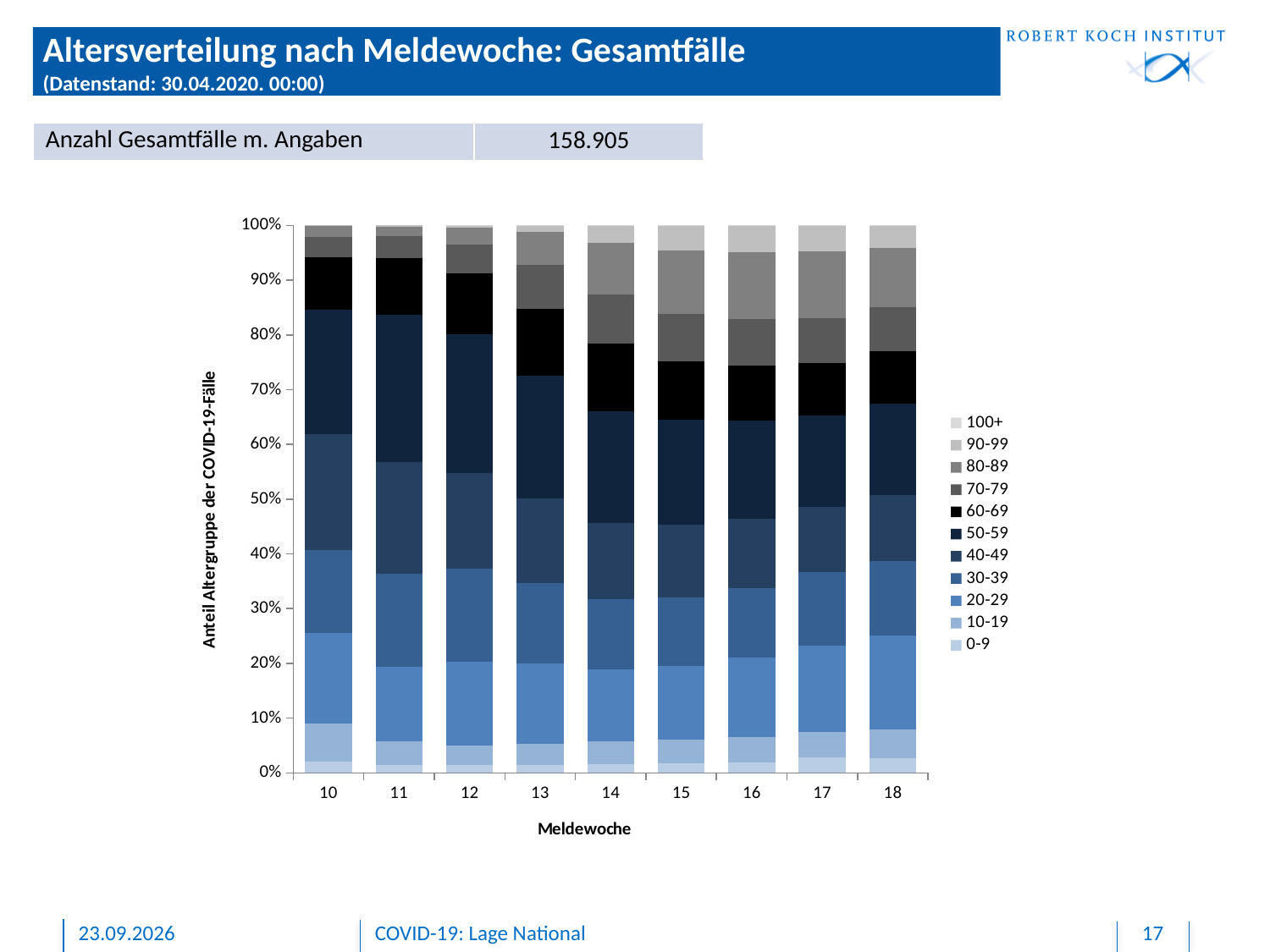
In week 18, which is larger: the share of the 80-89 age group or the share of the 0-9 age group? 80-89 What is the title of the slide's chart? Altersverteilung nach Meldewoche: Gesamtfälle What is the total height of each stacked bar? 100% Is the share of the 0-9 age group in week 10 greater or less than 10%? less What kind of chart is shown on the slide? Stacked bar chart What is the label of the x axis? Meldewoche Is the share of the 30-39 age group larger in week 10 or in week 18? Week 10 How many reporting weeks (Meldewochen) are shown on the x axis? 9 Does the share of the 80-89 age group rise or fall from week 10 to week 18? rise How many age groups does the legend list? 11 Is the share of the 20-29 age group in week 10 greater or less than 10%? greater Does the share of the 30-39 age group rise or fall from week 10 to week 18? fall